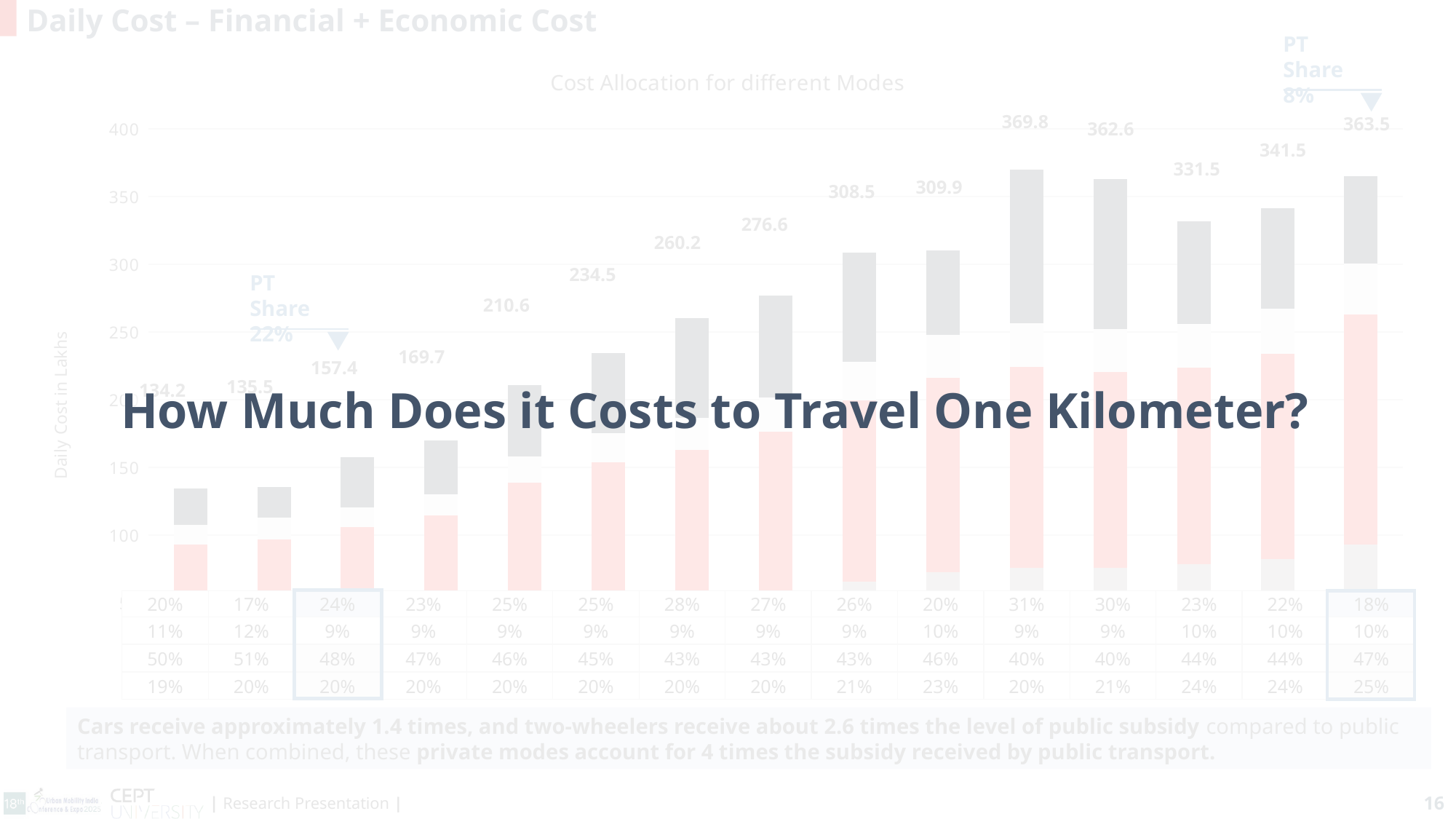
What is the highest total value labelled on any bar in the chart? 369.8 What is the title of the chart? Cost Allocation for different Modes What is the total value labelled above the first bar from the left? 134.2 What is the lowest total value labelled on any bar in the chart? 134.2 How many bars are plotted in the chart? 15 What is the label on the vertical axis of the chart? Daily Cost in Lakhs Which is larger, the total of the twelfth bar from the left (362.6) or the thirteenth bar (331.5)? the twelfth bar (362.6) What is the total value labelled above the last bar on the right? 363.5 What kind of chart is shown on the slide? bar chart Do the bar totals generally rise or fall from left to right across the chart? rise What is the difference between the total of the last bar (363.5) and the total of the first bar (134.2)? 229.3 What is the total value labelled above the third bar from the left? 157.4